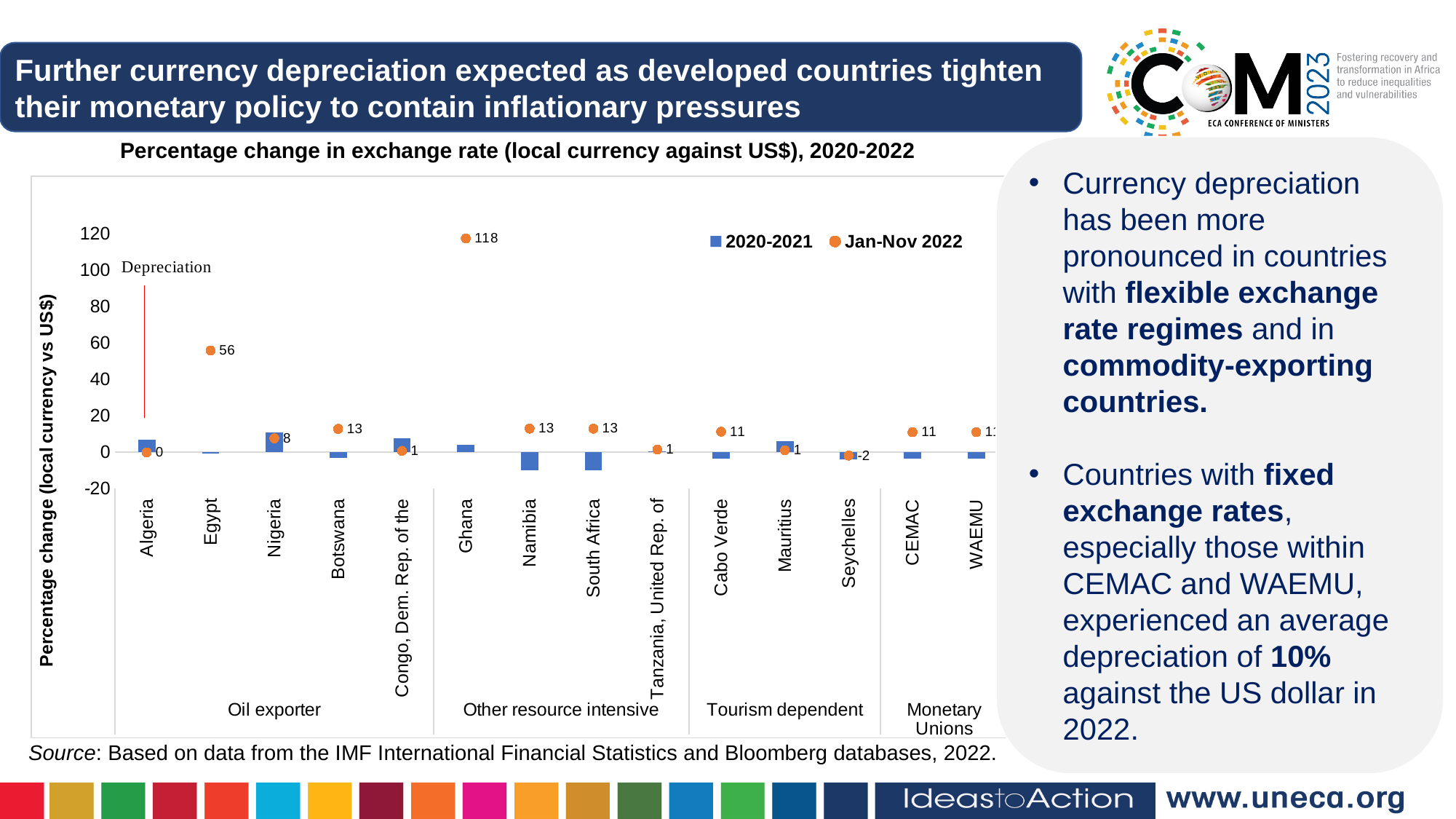
Which country has the highest Jan-Nov 2022 value? Ghana What is the Jan-Nov 2022 value for Egypt? 56 What is the Jan-Nov 2022 value for Ghana? 118 Is the Jan-Nov 2022 value for Egypt greater or less than 40? greater What kind of chart is used to plot the 2020-2021 series? bar chart Is the 2020-2021 value for Namibia greater or less than 0? less What is the Jan-Nov 2022 value for Seychelles? -2 How many series does the legend list? 2 Which has the larger Jan-Nov 2022 value, Botswana or Cabo Verde? Botswana Which country has the lowest Jan-Nov 2022 value? Seychelles What is the difference between the Jan-Nov 2022 values for Ghana and Egypt? 62 How many country groups are labelled along the x axis? 4